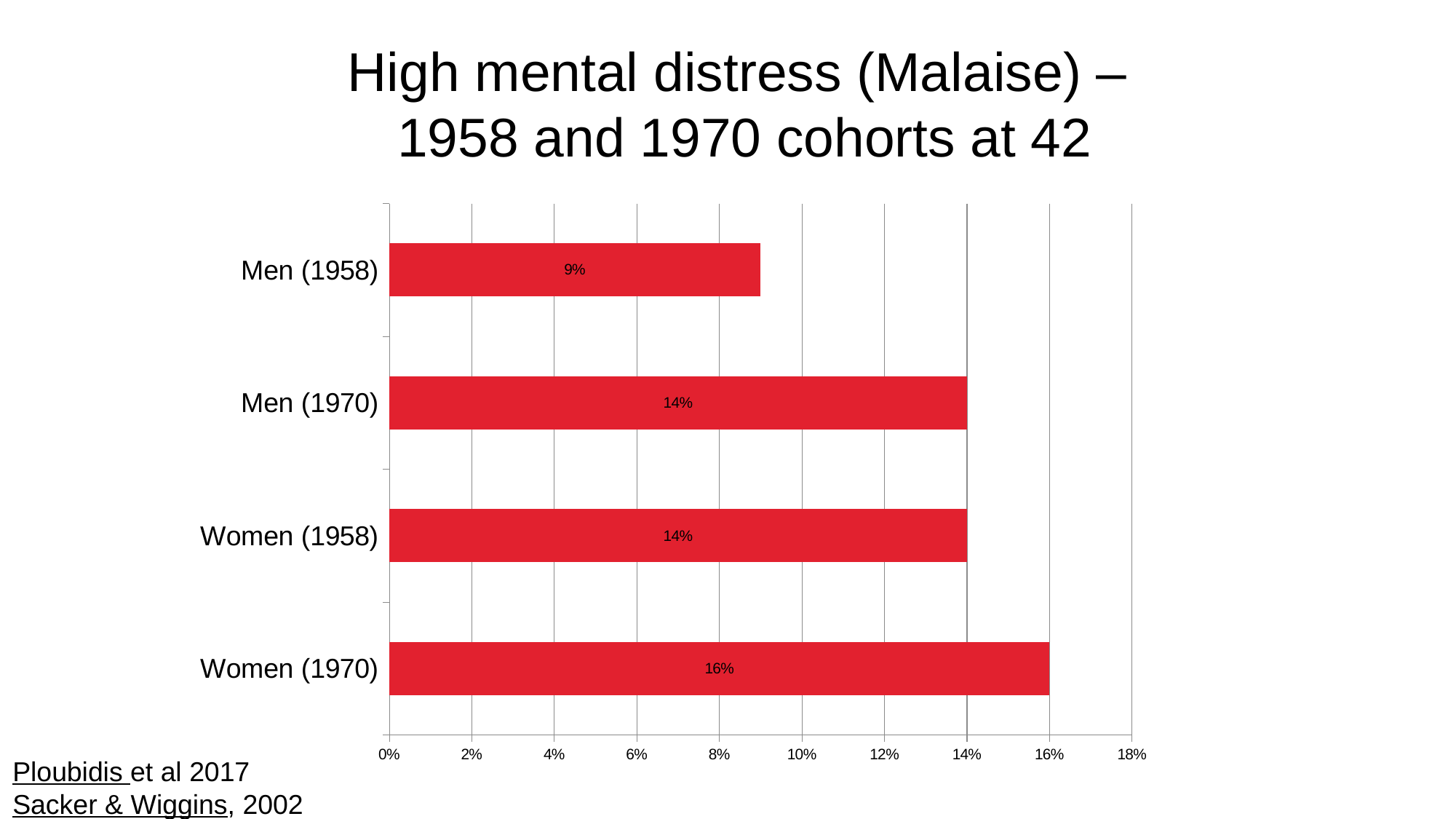
Is the value for Men (1958) greater or less than 10%? less Which category has the highest value? Women (1970) How many categories are shown in the chart? 4 What is the value for Women (1970)? 16% What is the value for Women (1958)? 14% What is the value for Men (1970)? 14% What is the value for Men (1958)? 9% What is the difference between the values for Men (1970) and Men (1958)? 5% What kind of chart is shown on the slide? Bar chart Which category has the lowest value? Men (1958) Which is larger, the value for Women (1970) or the value for Women (1958)? Women (1970) What is the difference between the values for Women (1970) and Men (1958)? 7%